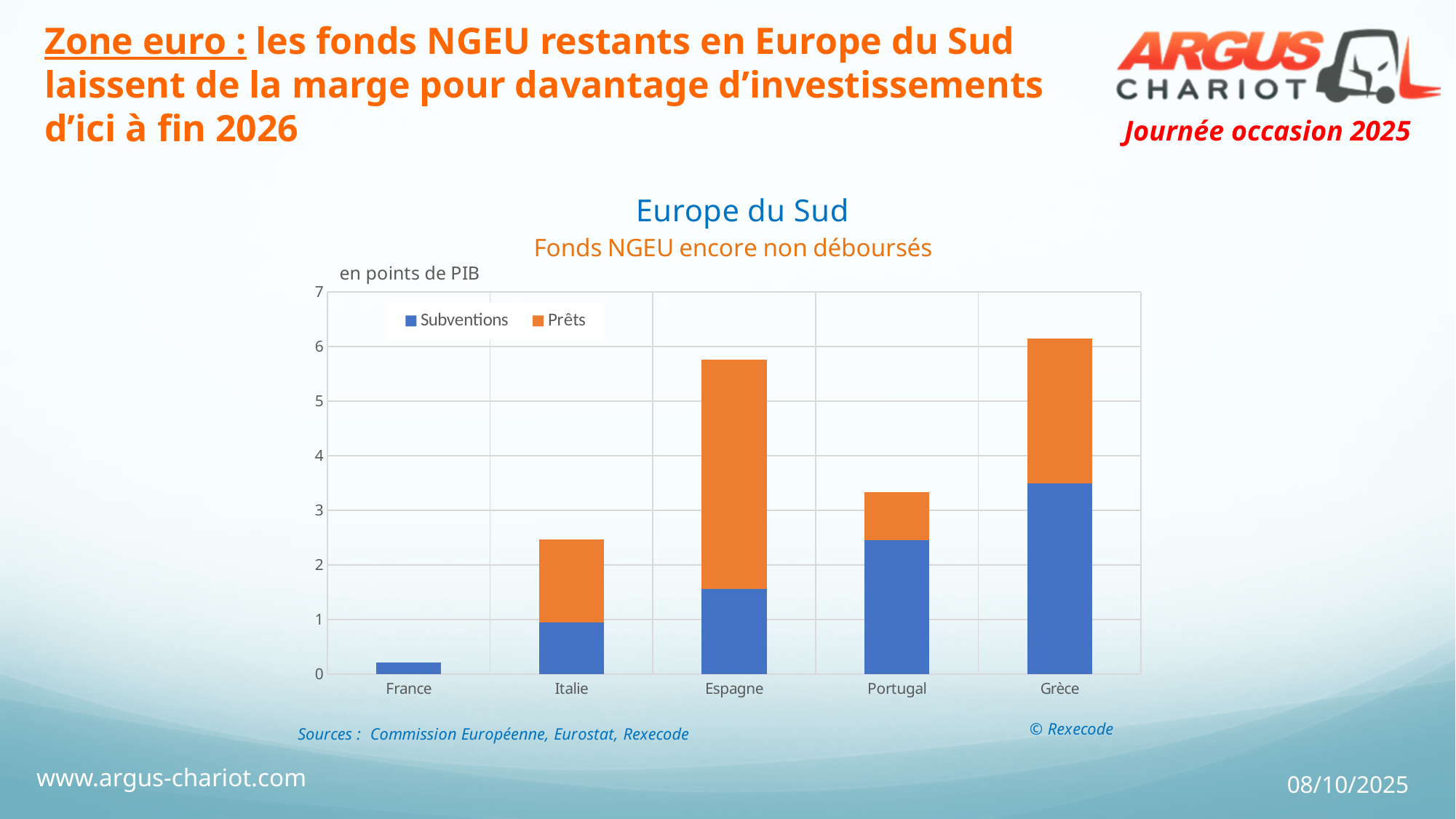
Is the total bar for Grèce greater or less than 6? greater Which country has a larger Subventions (blue) segment, Portugal or Espagne? Portugal Which country has a larger Prêts (orange) segment, Espagne or Italie? Espagne What kind of chart is shown on the slide? stacked bar chart How many countries are shown on the x axis of the chart? 5 Is the total bar for Espagne greater or less than 6? less In what unit are the values of the chart expressed, according to the axis label? en points de PIB How many series does the chart legend list? 2 Is the total bar for Portugal greater or less than 3? greater Which country has the lowest total of NGEU funds not yet disbursed? France Which country has the highest total of NGEU funds not yet disbursed? Grèce